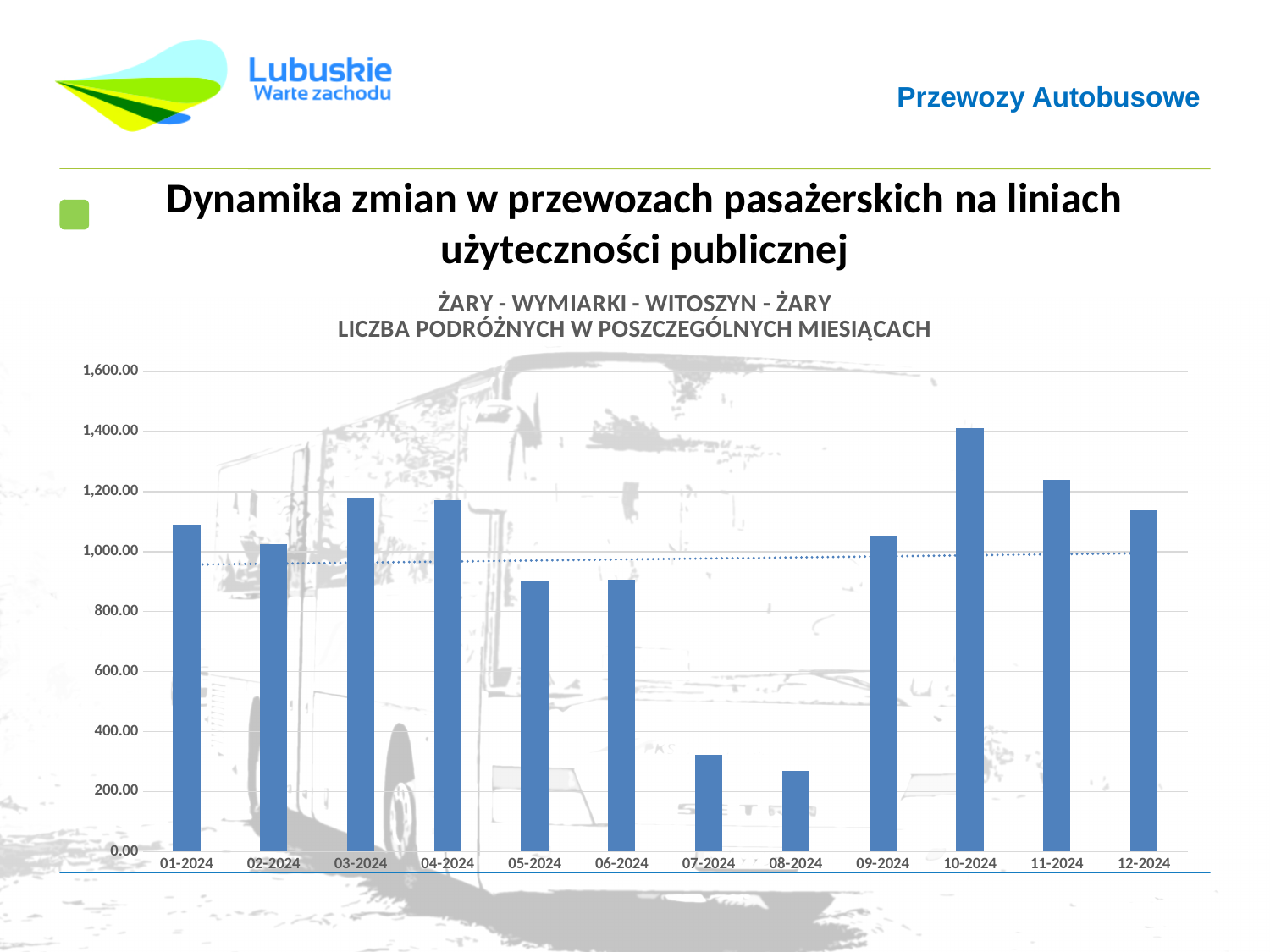
Which month has the highest number of passengers? 10-2024 Is the value for 05-2024 greater or less than 1,000.00? less Which month has more passengers, 10-2024 or 11-2024? 10-2024 Is the value for 08-2024 greater or less than 400.00? less Is the value for 10-2024 greater or less than 1,200.00? greater Which month has the lowest number of passengers? 08-2024 What kind of chart is shown on the slide? bar chart Do the values rise or fall from 10-2024 to 12-2024? fall How many months are shown on the x axis? 12 Which month has more passengers, 07-2024 or 08-2024? 07-2024